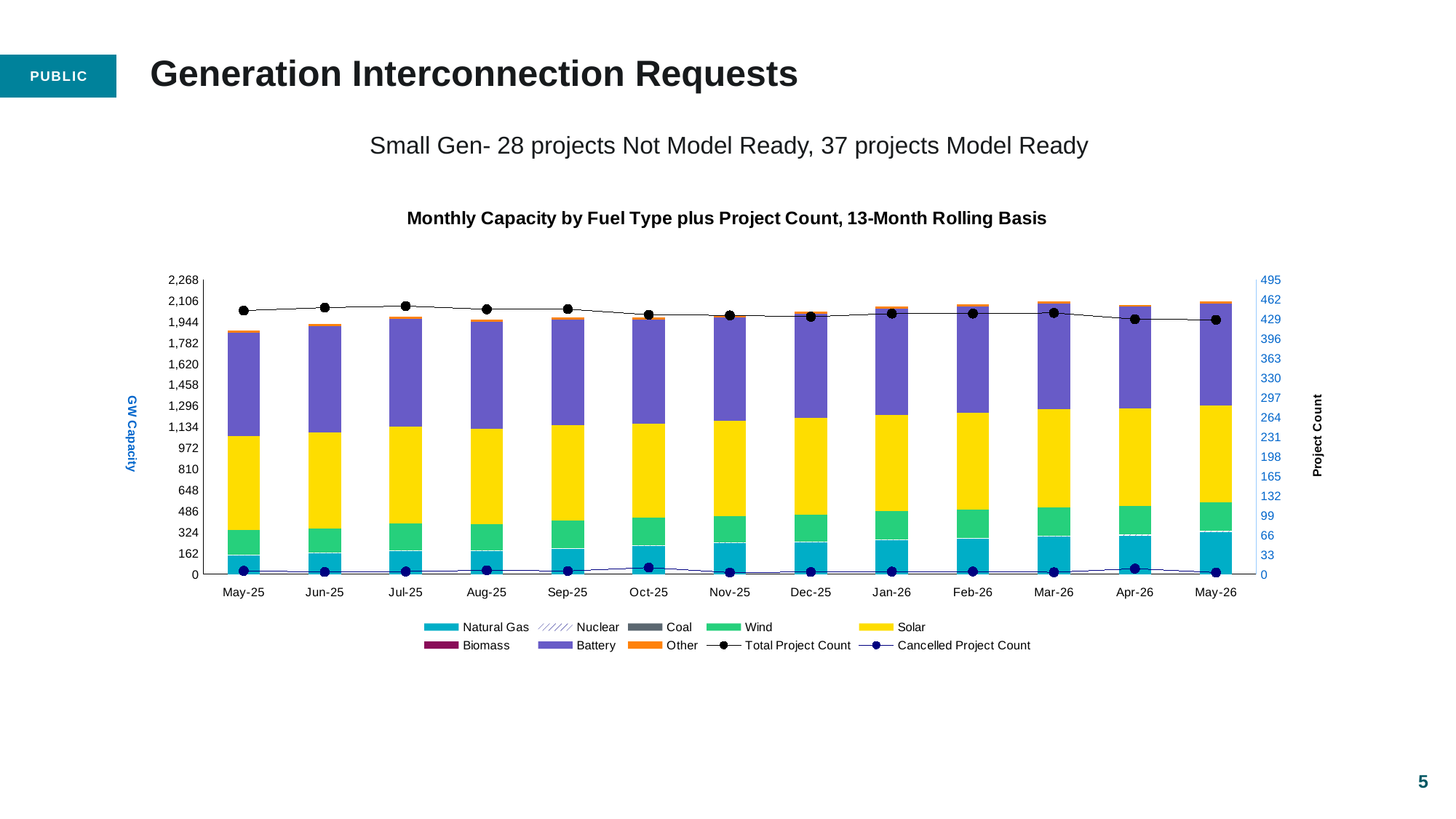
How many series does the chart legend list? 10 What kind of chart is shown on the slide? Stacked bar chart with line series Which month has the lowest total stacked capacity? May-25 Is the Total Project Count for Jul-25 greater or less than 429? greater Is the total stacked capacity for May-26 greater or less than 1,944? greater Does the Natural Gas segment generally rise or fall from May-25 to May-26? rise Is the Natural Gas value for May-25 greater or less than 162? less How many months are shown along the x axis of the chart? 13 What is the title of the chart? Monthly Capacity by Fuel Type plus Project Count, 13-Month Rolling Basis What is the label of the left vertical axis? GW Capacity Which is larger, the Natural Gas value for May-25 or for May-26? May-26